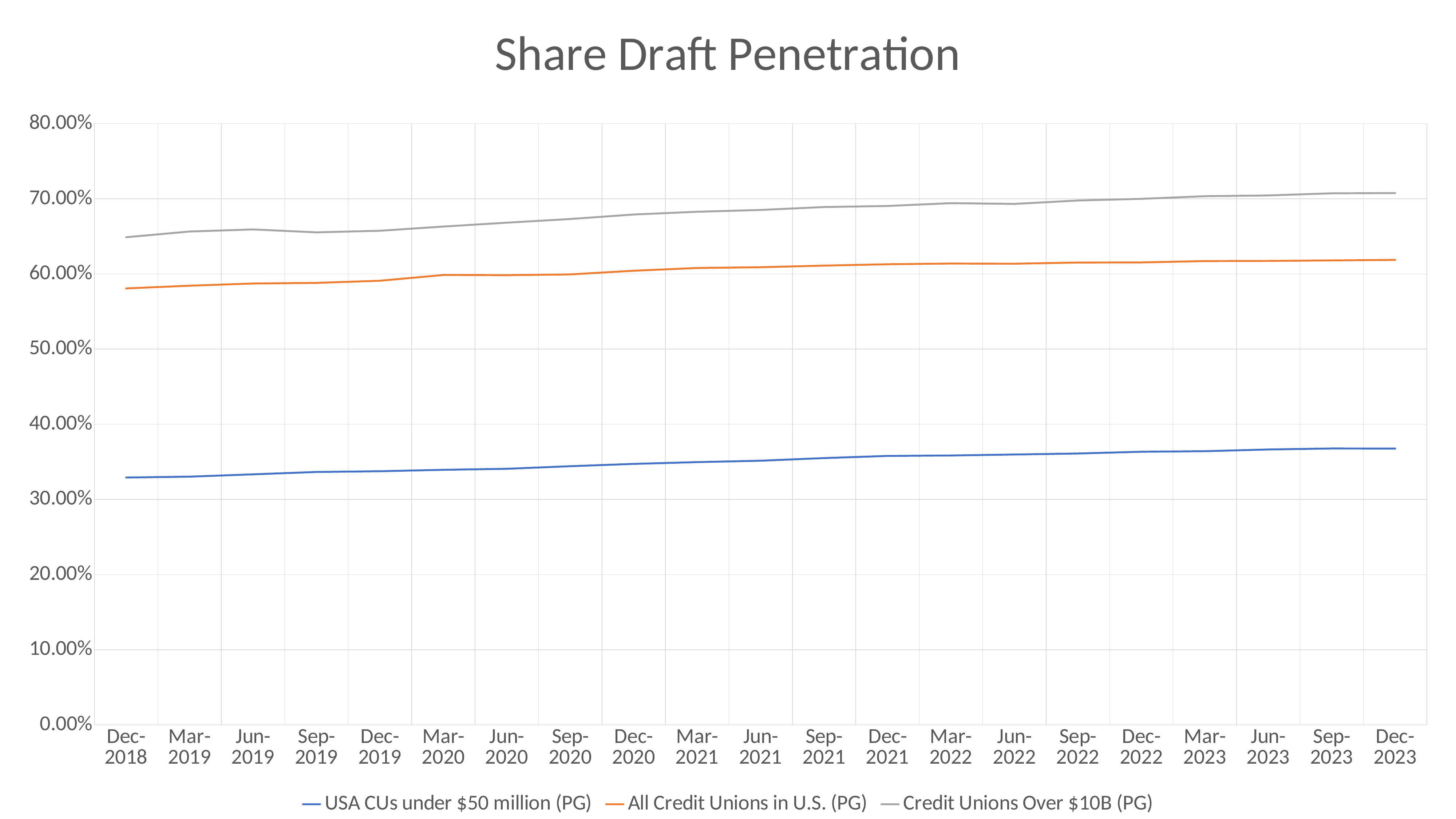
Is the value for All Credit Unions in U.S. (PG) at Dec-2023 greater or less than 60.00%? greater How many series does the legend list? 3 What kind of chart is shown on the slide? line chart How many time points are shown along the x axis? 21 Is the value for USA CUs under $50 million (PG) at Dec-2023 greater or less than 40.00%? less Does the USA CUs under $50 million (PG) series rise or fall from Dec-2018 to Dec-2023? rise Is the value for All Credit Unions in U.S. (PG) at Dec-2018 greater or less than 60.00%? less What is the title of the chart? Share Draft Penetration Which series has the lowest share draft penetration throughout the chart? USA CUs under $50 million (PG) Which series has the highest share draft penetration throughout the chart? Credit Unions Over $10B (PG)